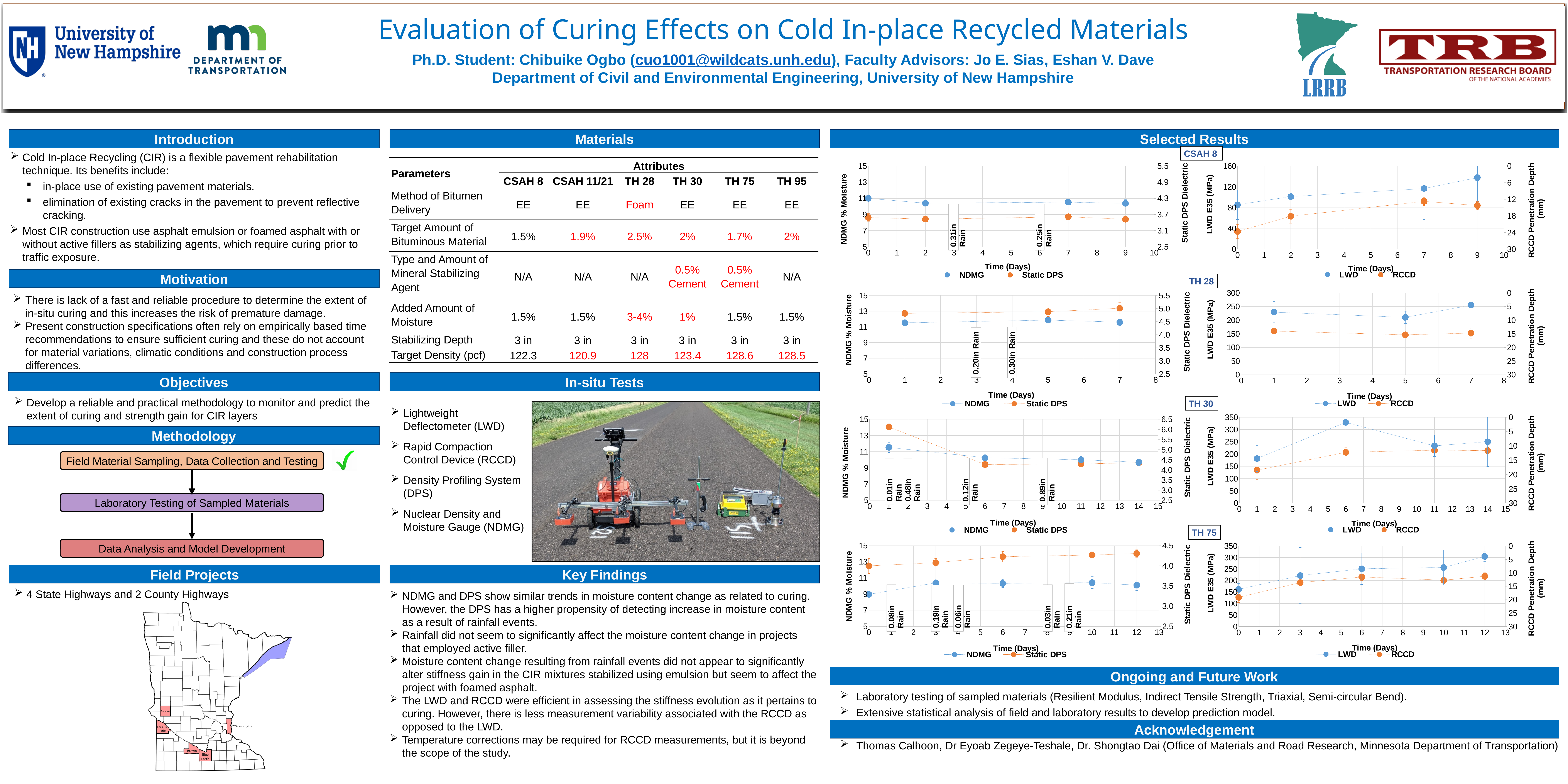
In the CSAH 8 LWD/RCCD chart, is the LWD E35 value at day 0 greater or less than 100? less In the TH 28 LWD/RCCD chart, is the LWD E35 value at day 7 greater or less than 200? greater What kind of chart is the CSAH 8 LWD/RCCD chart? line chart In the TH 30 LWD/RCCD chart, is the LWD E35 value at day 6 greater or less than 300? greater In the TH 75 NDMG/Static DPS chart, does the Static DPS dielectric value rise or fall over time? rise In the CSAH 8 LWD/RCCD chart, does the LWD E35 value rise or fall over time? rise What are the two legend entries in the TH 75 LWD/RCCD chart? LWD and RCCD In the CSAH 8 NDMG/Static DPS chart, what are the two rain amounts annotated? 0.31in and 0.25in In the CSAH 8 NDMG/Static DPS chart, how many series does the legend list? 2